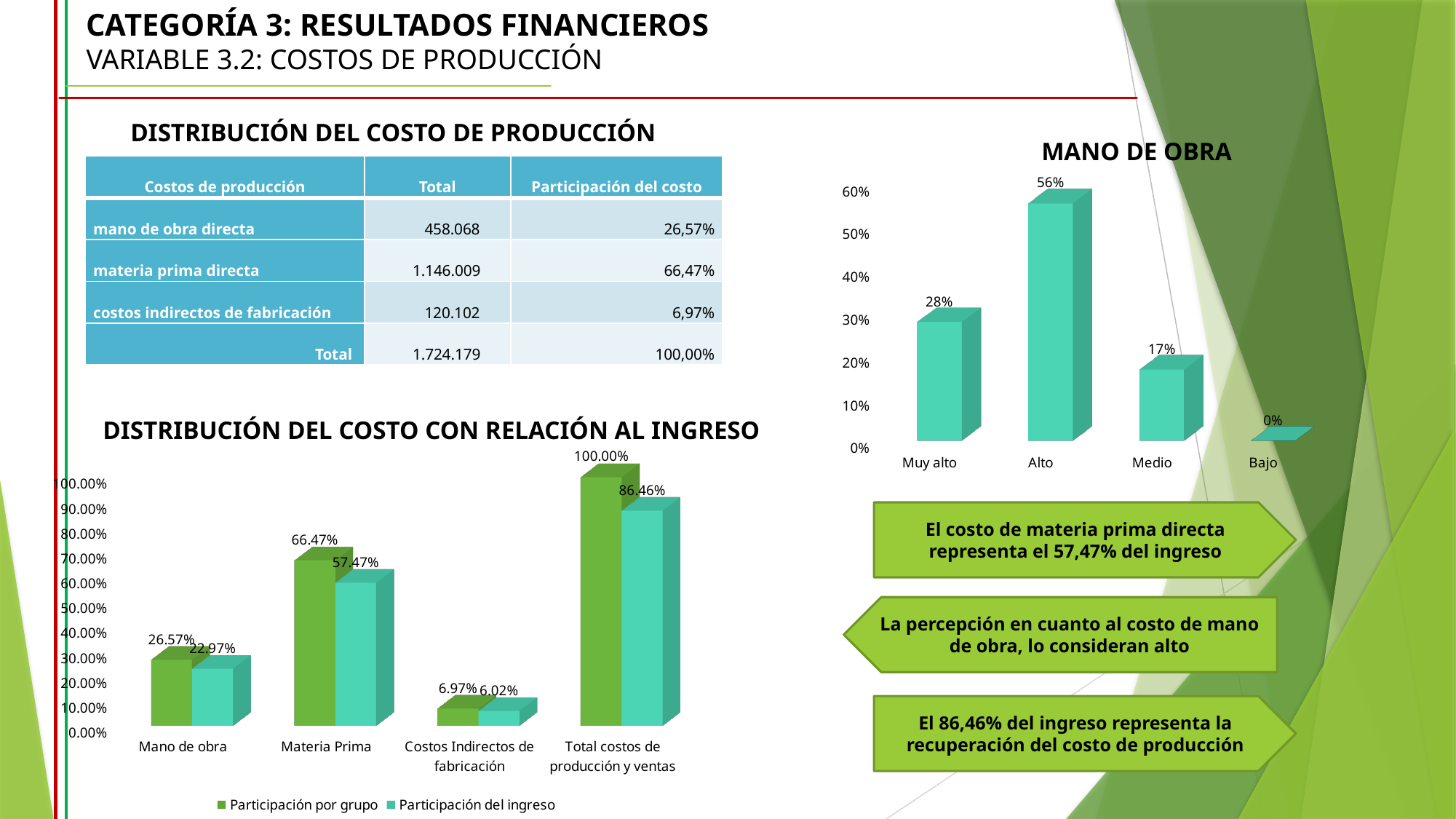
In the 'DISTRIBUCIÓN DEL COSTO CON RELACIÓN AL INGRESO' chart, which is larger for 'Materia Prima': 'Participación por grupo' or 'Participación del ingreso'? Participación por grupo In the 'MANO DE OBRA' chart, what is the value for 'Alto'? 56% In the 'MANO DE OBRA' chart, what is the difference between the values for 'Alto' and 'Muy alto'? 28% What kind of chart is the 'MANO DE OBRA' chart? Bar chart In the 'DISTRIBUCIÓN DEL COSTO CON RELACIÓN AL INGRESO' chart, which category has the lowest 'Participación del ingreso' value? Costos Indirectos de fabricación In the 'DISTRIBUCIÓN DEL COSTO CON RELACIÓN AL INGRESO' chart, how many series does the legend list? 2 In the 'DISTRIBUCIÓN DEL COSTO CON RELACIÓN AL INGRESO' chart, what is the 'Participación por grupo' value for 'Mano de obra'? 26.57% In the 'MANO DE OBRA' chart, how many categories are shown on the x axis? 4 In the 'DISTRIBUCIÓN DEL COSTO CON RELACIÓN AL INGRESO' chart, what is the difference between the 'Participación por grupo' and 'Participación del ingreso' values for 'Total costos de producción y ventas'? 13.54% In the 'MANO DE OBRA' chart, which category has the highest value? Alto In the 'DISTRIBUCIÓN DEL COSTO CON RELACIÓN AL INGRESO' chart, what is the 'Participación del ingreso' value for 'Materia Prima'? 57.47% In the 'MANO DE OBRA' chart, which category has the lowest value? Bajo